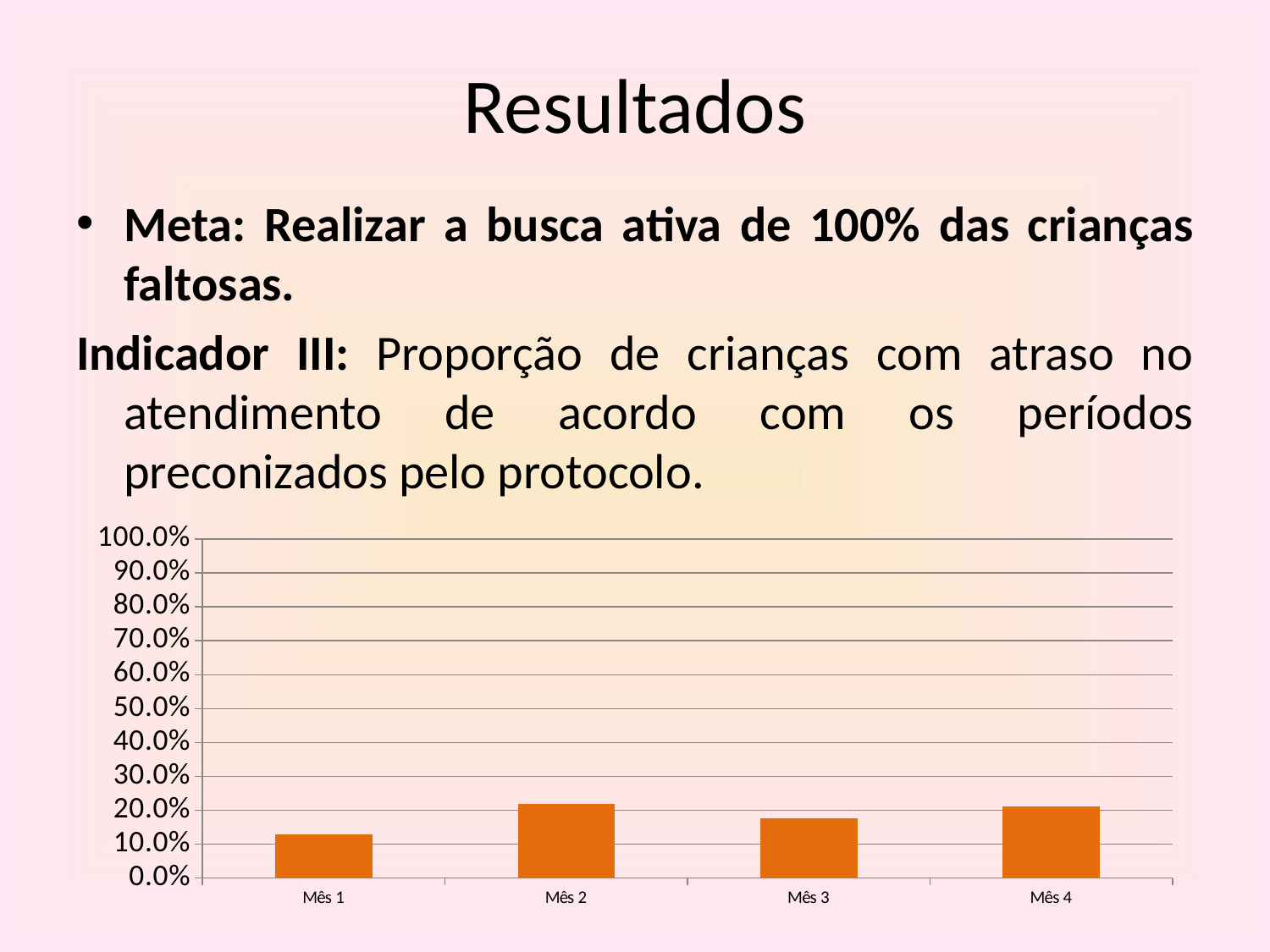
Which is larger, the value for Mês 1 or the value for Mês 2? Mês 2 Which is larger, the value for Mês 3 or the value for Mês 1? Mês 3 Is the value for Mês 4 greater or less than 10.0%? greater What colour are the bars in the chart? orange Is the value for Mês 3 greater or less than 20.0%? less Is the value for Mês 1 greater or less than 20.0%? less How many categories are shown on the x axis of the chart? 4 Which month has the lowest value in the chart? Mês 1 What is the highest value shown on the y axis of the chart? 100.0% What kind of chart is shown on the slide? bar chart